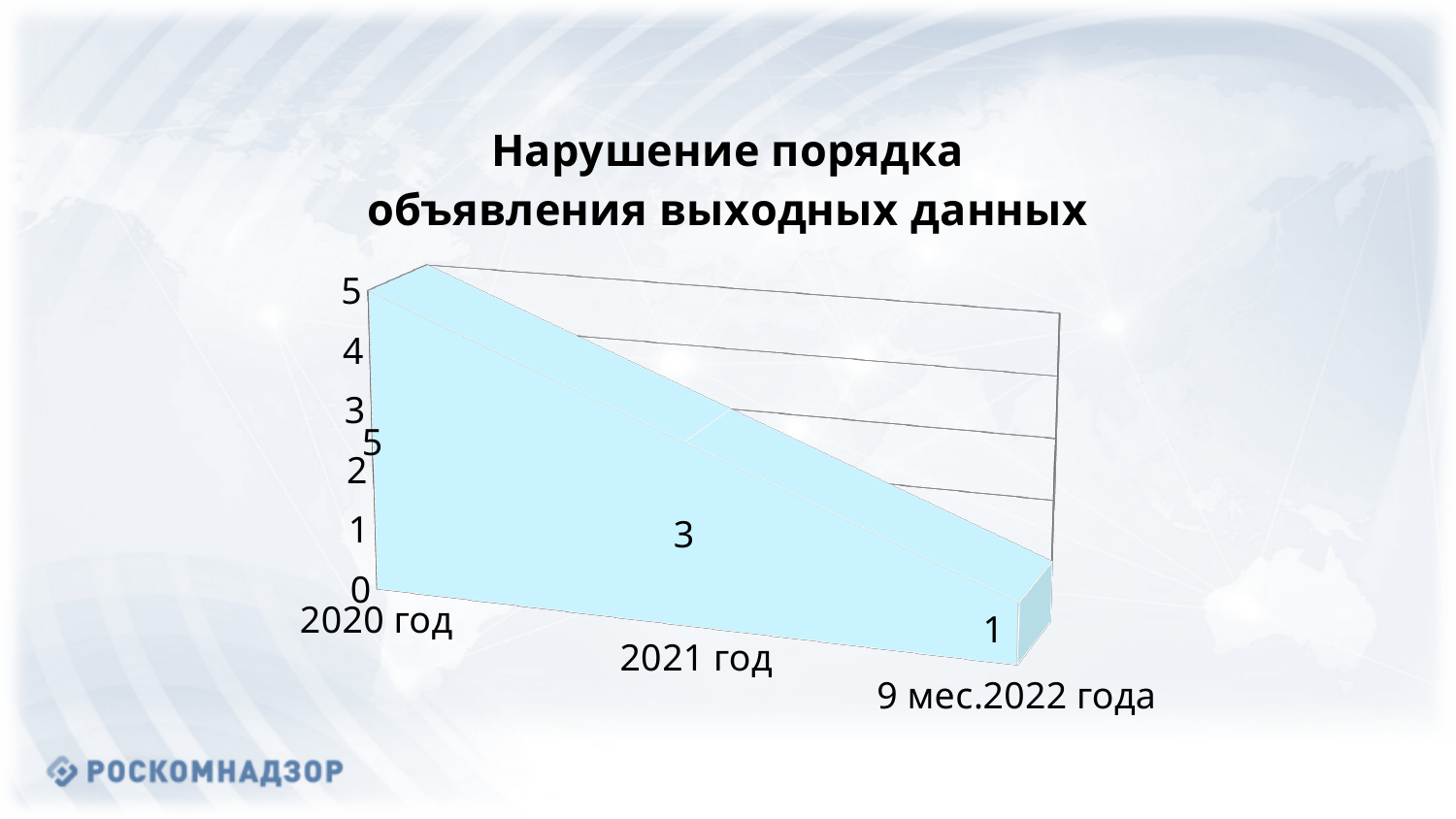
What is the value for 2020 год? 5 What is the value for 2021 год? 3 What kind of chart is shown on the slide? area chart What is the difference between the values for 2021 год and 9 мес.2022 года? 2 How many categories are shown on the x axis? 3 What is the title of the chart? Нарушение порядка объявления выходных данных Do the values rise or fall from 2020 год to 9 мес.2022 года? fall Which is larger, the value for 2020 год or the value for 9 мес.2022 года? 2020 год What is the value for 9 мес.2022 года? 1 Which category has the lowest value? 9 мес.2022 года Which category has the highest value? 2020 год What is the difference between the values for 2020 год and 2021 год? 2